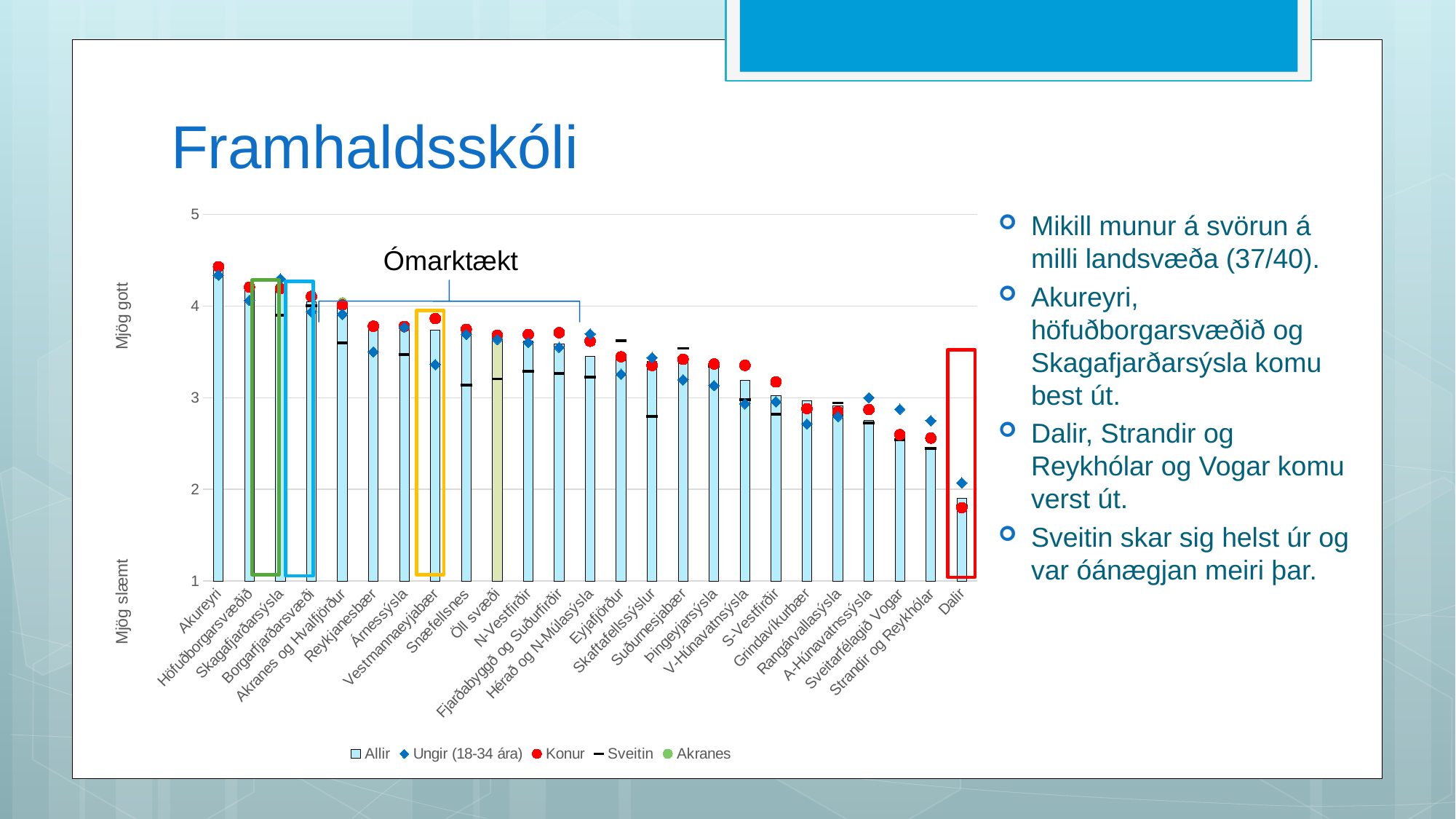
Do the Allir bars rise or fall from left to right along the x axis? Fall What label appears at the top of the chart's y axis? Mjög gott What is the title of the slide containing the chart? Framhaldsskóli Is the Allir value for Dalir greater or less than 2? less What kind of chart is shown on the slide? Bar chart Which category has the lowest Allir bar? Dalir How many categories are plotted along the x axis of the chart? 25 Is the Allir value for Akureyri greater or less than 4? greater How many series does the chart legend list? 5 Is the Allir value for Strandir og Reykhólar greater or less than 3? less Which category has the highest Allir bar? Akureyri Which has the larger Allir bar, Reykjanesbær or Grindavíkurbær? Reykjanesbær